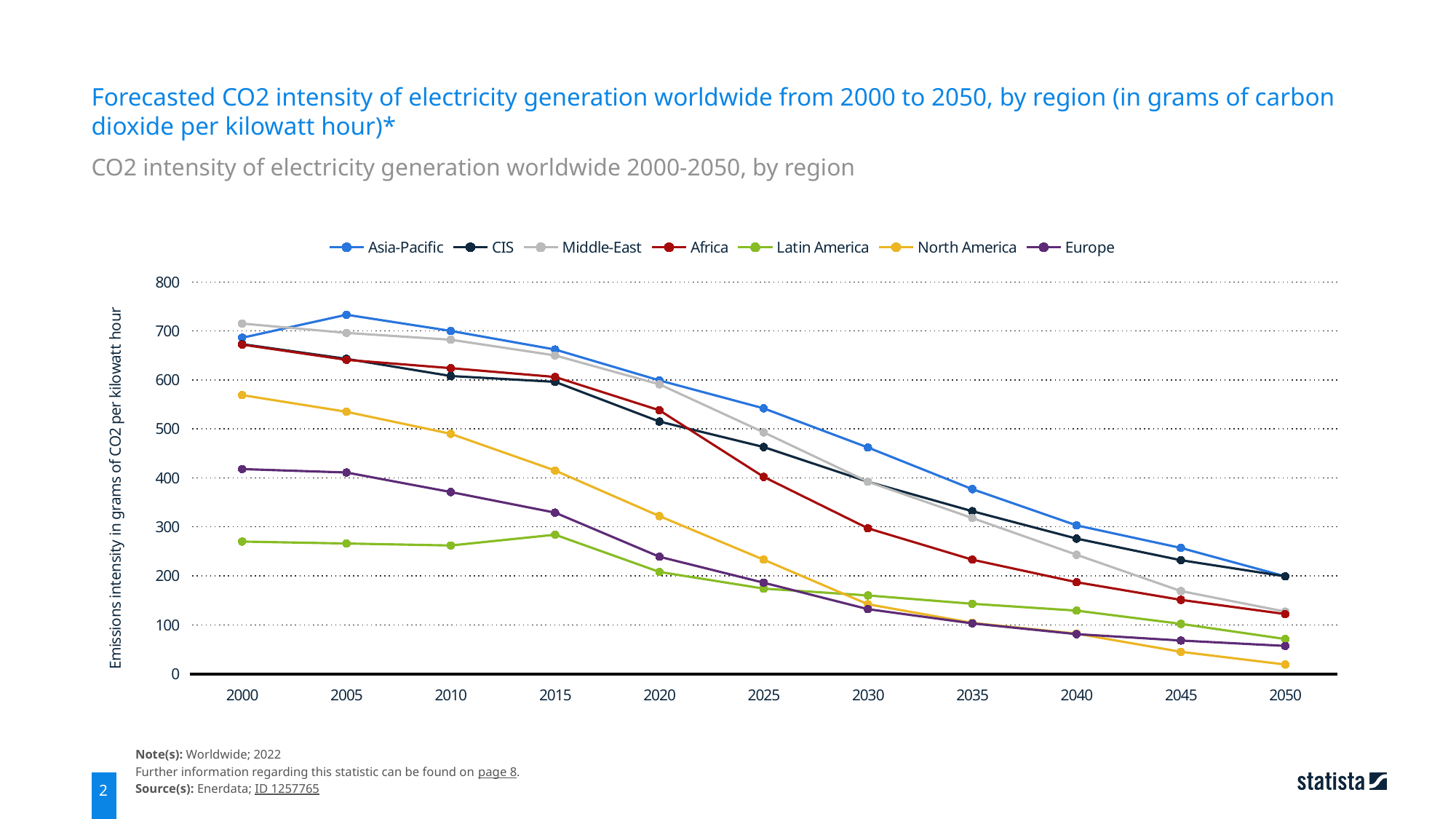
What kind of chart is shown on the slide? line chart Does the value for North America rise or fall from 2000 to 2050? fall Is the value for Latin America in 2000 greater or less than 300? less Is the value for North America in 2050 greater or less than 100? less Which region has the lowest CO2 intensity in 2000? Latin America How many series does the legend list? 7 In 2020, which is larger: the value for Asia-Pacific or the value for Europe? Asia-Pacific How many years are plotted along the x axis? 11 What is the label of the y axis? Emissions intensity in grams of CO2 per kilowatt hour Which region has the lowest CO2 intensity in 2050? North America Is the value for Asia-Pacific in 2005 greater or less than 700? greater Which region has the highest CO2 intensity in 2000? Middle-East